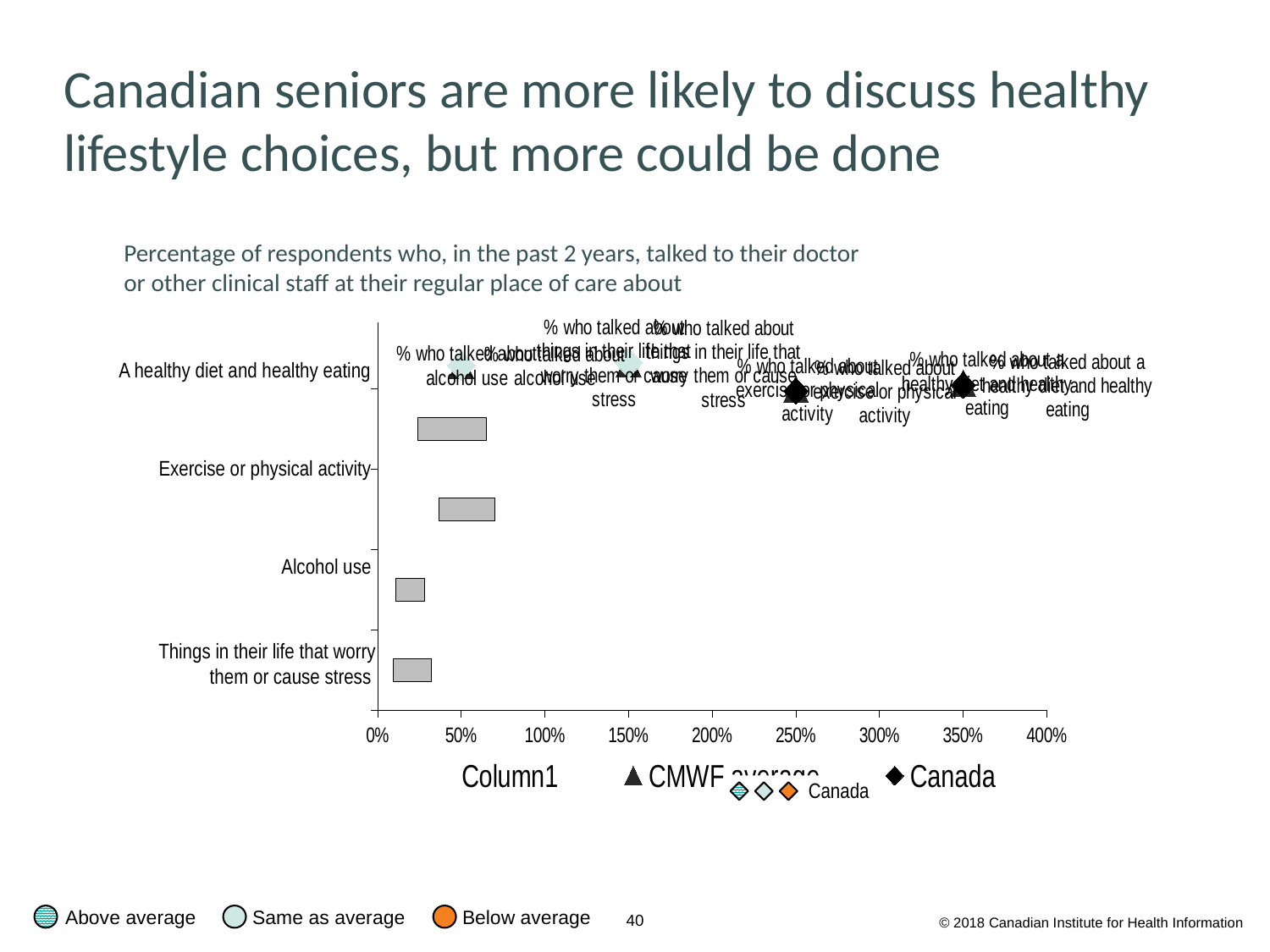
What is the highest value shown on the horizontal axis of the chart? 400% How many categories are listed on the vertical axis of the chart? 4 Is the bar for Exercise or physical activity greater or less than 100%? less How many series does the chart legend list? 3 What kind of chart is shown on the slide? Bar chart Is the bar for A healthy diet and healthy eating greater or less than 150%? less Which bar extends further to the right: Exercise or physical activity, or Alcohol use? Exercise or physical activity What are the entries in the chart legend? Column1, CMWF average, Canada Is the bar for Things in their life that worry them or cause stress greater or less than 100%? less